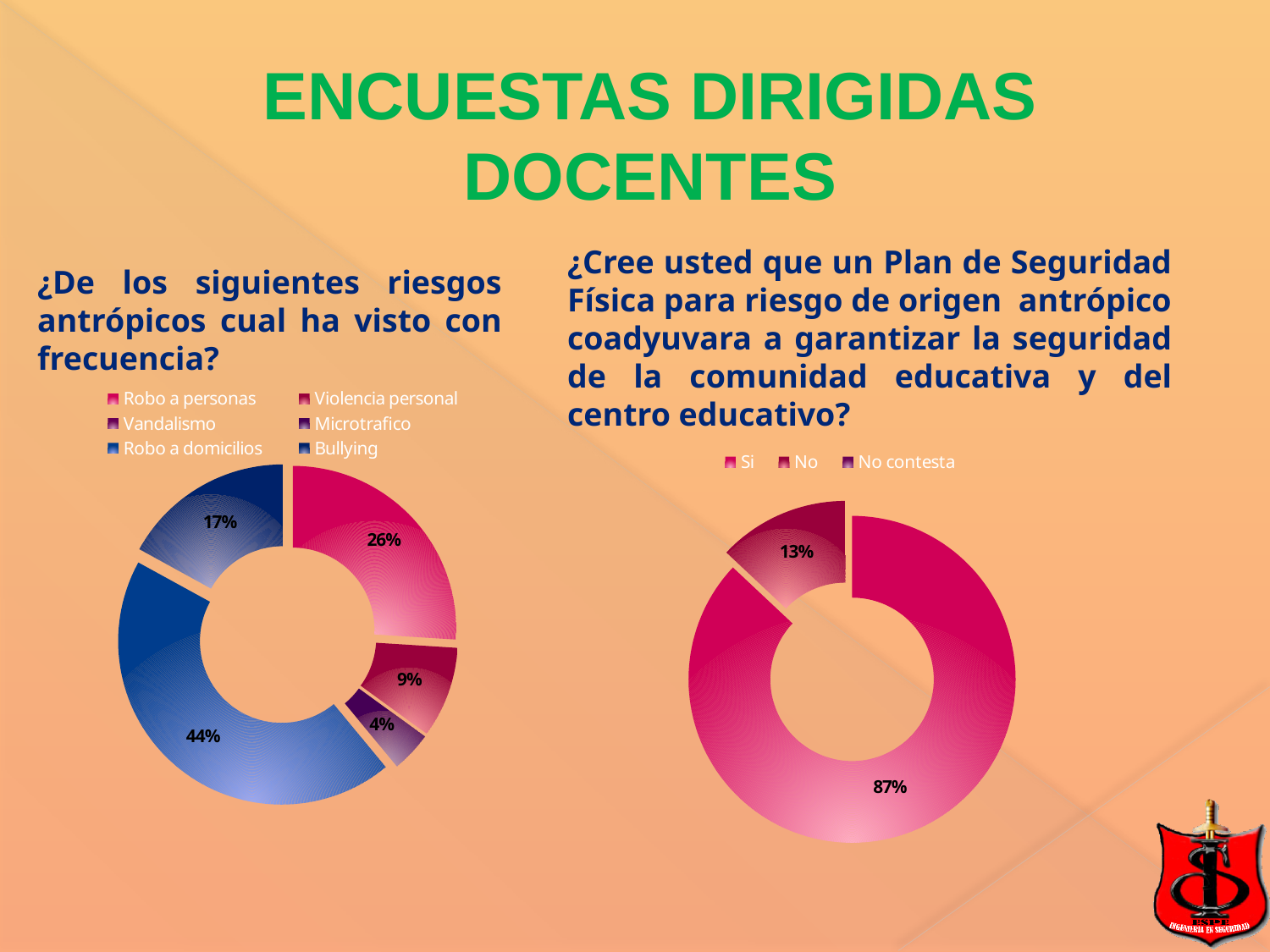
In the right chart (¿Cree usted que un Plan de Seguridad Física...?), what is the difference in percentage points between Si and No? 74 percentage points In the left chart (¿De los siguientes riesgos antrópicos cual ha visto con frecuencia?), what percentage corresponds to Robo a personas? 26% What kind of chart is the right chart (¿Cree usted que un Plan de Seguridad Física...?)? Doughnut chart In the left chart (¿De los siguientes riesgos antrópicos cual ha visto con frecuencia?), which category has the largest share? Robo a domicilios How many entries does the legend of the left chart (¿De los siguientes riesgos antrópicos cual ha visto con frecuencia?) list? 6 In the right chart (¿Cree usted que un Plan de Seguridad Física...?), which response is larger, Si or No? Si In the left chart (¿De los siguientes riesgos antrópicos cual ha visto con frecuencia?), what is the difference in percentage points between Robo a domicilios and Robo a personas? 18 percentage points In the left chart (¿De los siguientes riesgos antrópicos cual ha visto con frecuencia?), what percentage corresponds to Robo a domicilios? 44% How many entries does the legend of the right chart (¿Cree usted que un Plan de Seguridad Física...?) list? 3 In the left chart (¿De los siguientes riesgos antrópicos cual ha visto con frecuencia?), what percentage corresponds to Bullying? 17% In the right chart (¿Cree usted que un Plan de Seguridad Física...?), what percentage answered No? 13% In the right chart (¿Cree usted que un Plan de Seguridad Física...?), what percentage answered Si? 87%